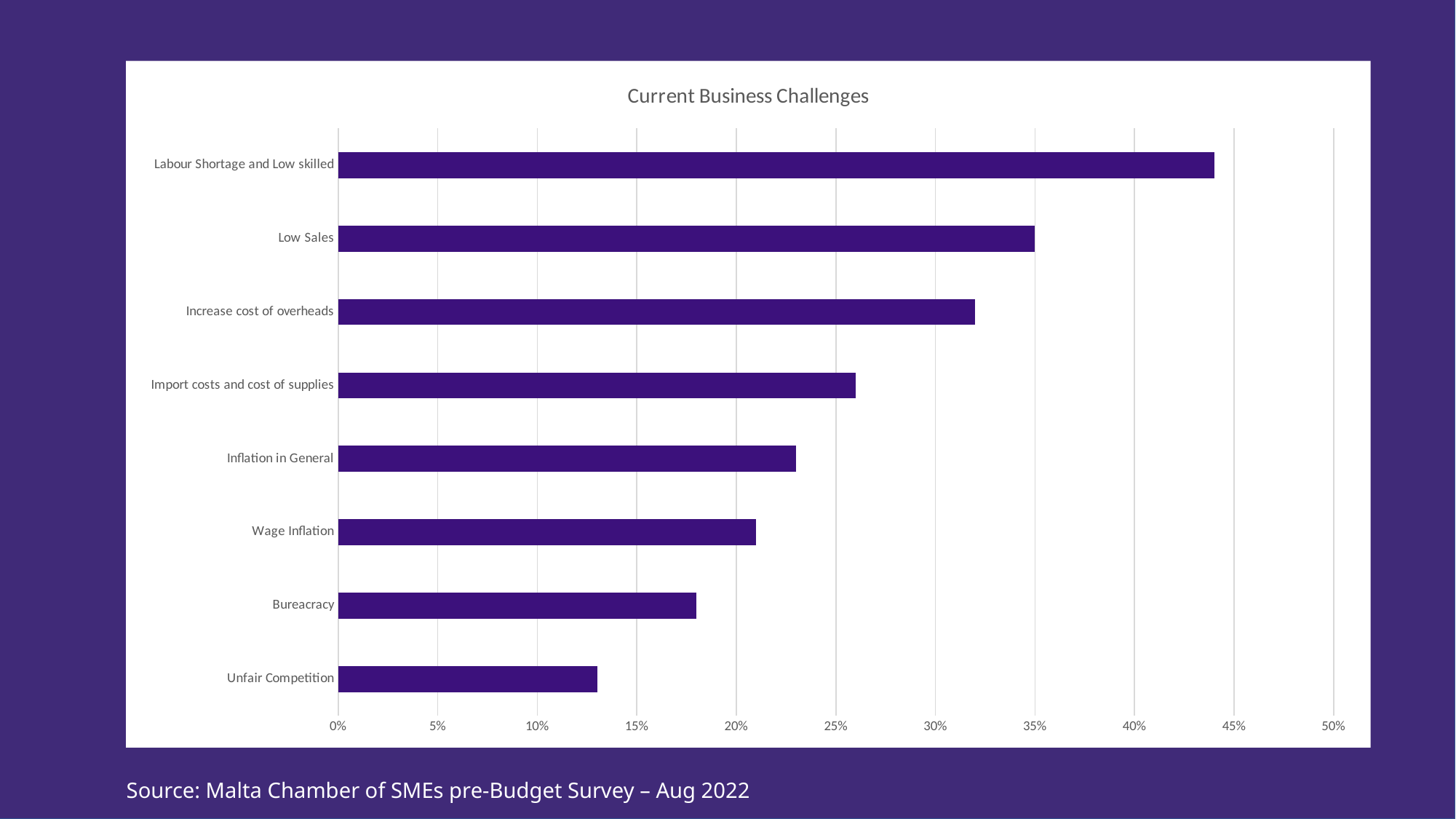
How many business challenges are plotted in the chart? 8 What is the value for Low Sales? 35% Is the value for Increase cost of overheads greater or less than 30%? greater Is the value for Unfair Competition greater or less than 15%? less Which business challenge has the highest value? Labour Shortage and Low skilled Is the value for Labour Shortage and Low skilled greater or less than 40%? greater Which is larger, the value for Inflation in General or the value for Increase cost of overheads? Increase cost of overheads Which is larger, the value for Import costs and cost of supplies or the value for Wage Inflation? Import costs and cost of supplies What kind of chart is shown on the slide? bar chart What is the title of the chart? Current Business Challenges Which business challenge has the lowest value? Unfair Competition